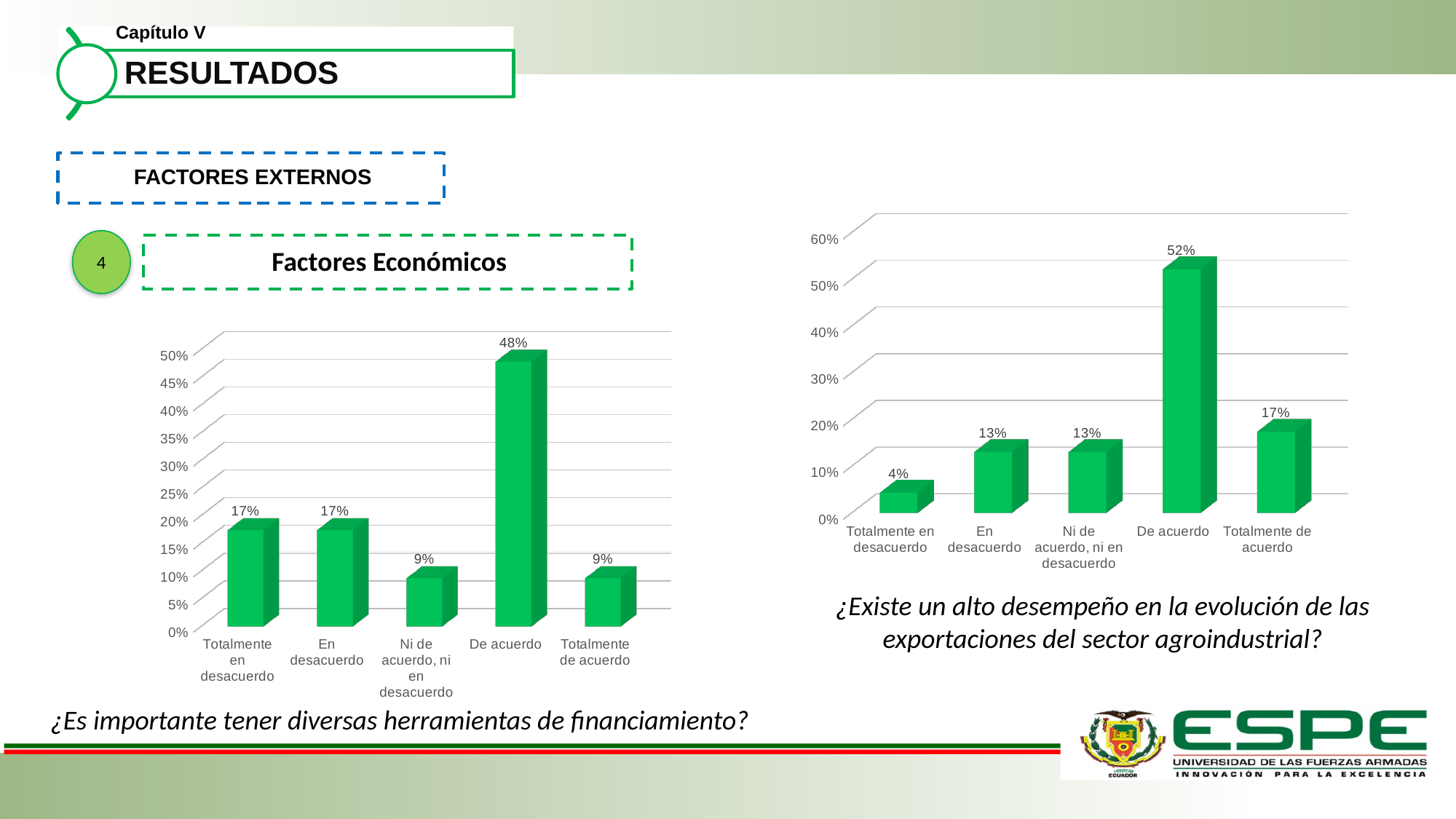
In the right chart (¿Existe un alto desempeño en la evolución de las exportaciones del sector agroindustrial?), what is the value for Totalmente en desacuerdo? 4% What kind of chart is the left chart (¿Es importante tener diversas herramientas de financiamiento?)? Bar chart In the right chart (¿Existe un alto desempeño en la evolución de las exportaciones del sector agroindustrial?), which category has the lowest value? Totalmente en desacuerdo In the left chart (¿Es importante tener diversas herramientas de financiamiento?), what is the difference between De acuerdo and En desacuerdo? 31% In the right chart (¿Existe un alto desempeño en la evolución de las exportaciones del sector agroindustrial?), is the value for De acuerdo greater or less than 50%? greater In the left chart (¿Es importante tener diversas herramientas de financiamiento?), which category has the highest value? De acuerdo In the right chart (¿Existe un alto desempeño en la evolución de las exportaciones del sector agroindustrial?), what is the value for De acuerdo? 52% In the left chart (¿Es importante tener diversas herramientas de financiamiento?), what is the value for Totalmente de acuerdo? 9% In the right chart (¿Existe un alto desempeño en la evolución de las exportaciones del sector agroindustrial?), what is the difference between De acuerdo and Totalmente de acuerdo? 35% In the left chart (¿Es importante tener diversas herramientas de financiamiento?), how many categories are shown? 5 In the right chart (¿Existe un alto desempeño en la evolución de las exportaciones del sector agroindustrial?), which is larger: Totalmente de acuerdo or En desacuerdo? Totalmente de acuerdo In the left chart (¿Es importante tener diversas herramientas de financiamiento?), what is the value for De acuerdo? 48%